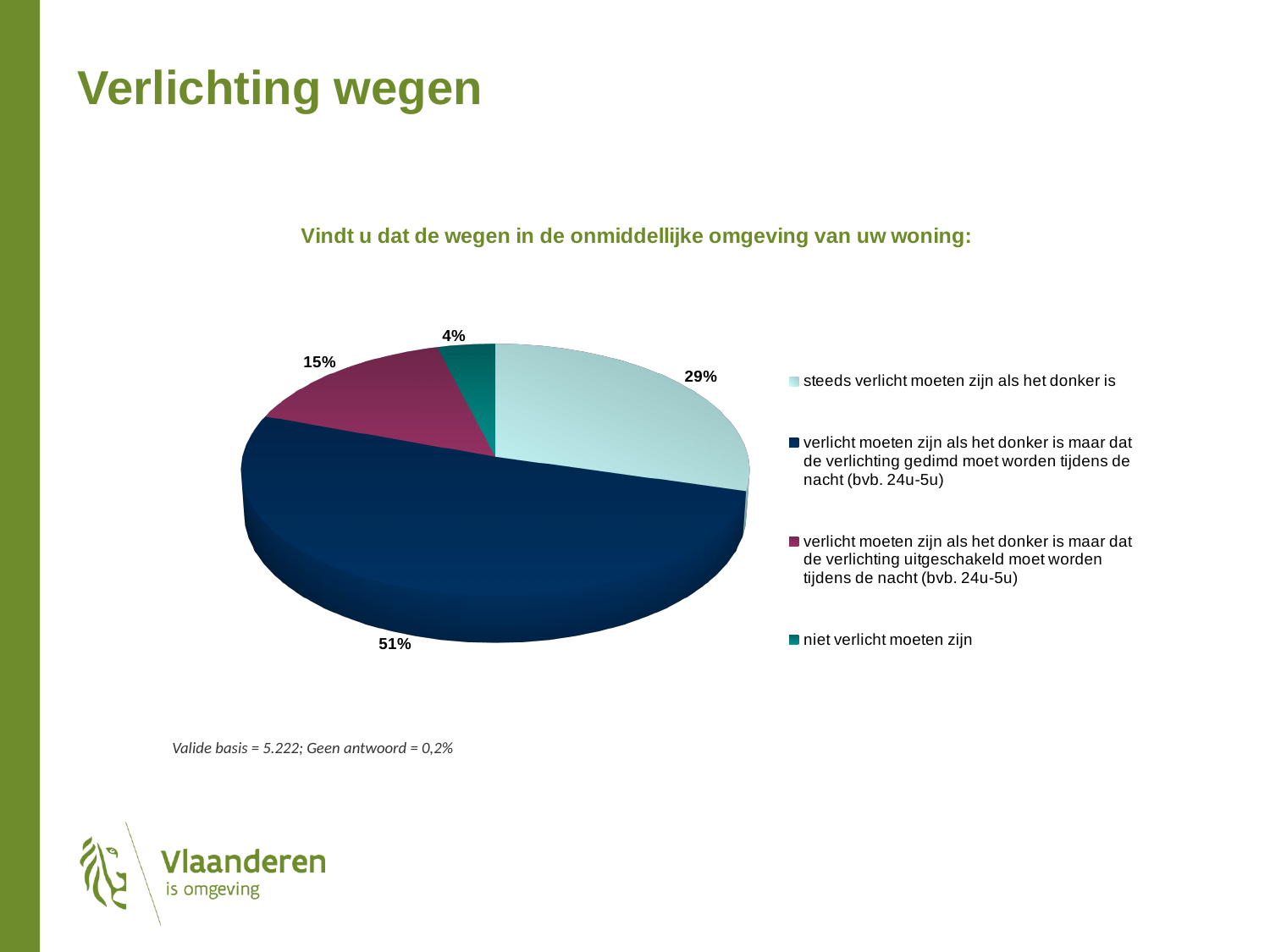
What is the difference in percentage points between the 'gedimd' option (51%) and the 'steeds verlicht' option (29%)? 22 percentage points What share of respondents think the roads should be lit when dark but dimmed during the night ("gedimd moet worden tijdens de nacht")? 51% Which is larger: the share for 'uitgeschakeld tijdens de nacht' or the share for 'niet verlicht moeten zijn'? uitgeschakeld tijdens de nacht What share of respondents think the roads should not be lit ("niet verlicht moeten zijn")? 4% What is the question shown above the pie chart? Vindt u dat de wegen in de onmiddellijke omgeving van uw woning: What share of respondents think the roads should be lit when dark but switched off during the night ("uitgeschakeld moet worden tijdens de nacht")? 15% Which answer option has the largest share of the pie? verlicht moeten zijn als het donker is maar dat de verlichting gedimd moet worden tijdens de nacht (bvb. 24u-5u) What kind of chart is shown on the slide? pie chart What is the valid base (Valide basis) stated below the chart? 5.222 How many slices does the pie chart have? 4 What share of respondents think the roads should always be lit when it is dark ("steeds verlicht moeten zijn als het donker is")? 29% Which answer option has the smallest share of the pie? niet verlicht moeten zijn